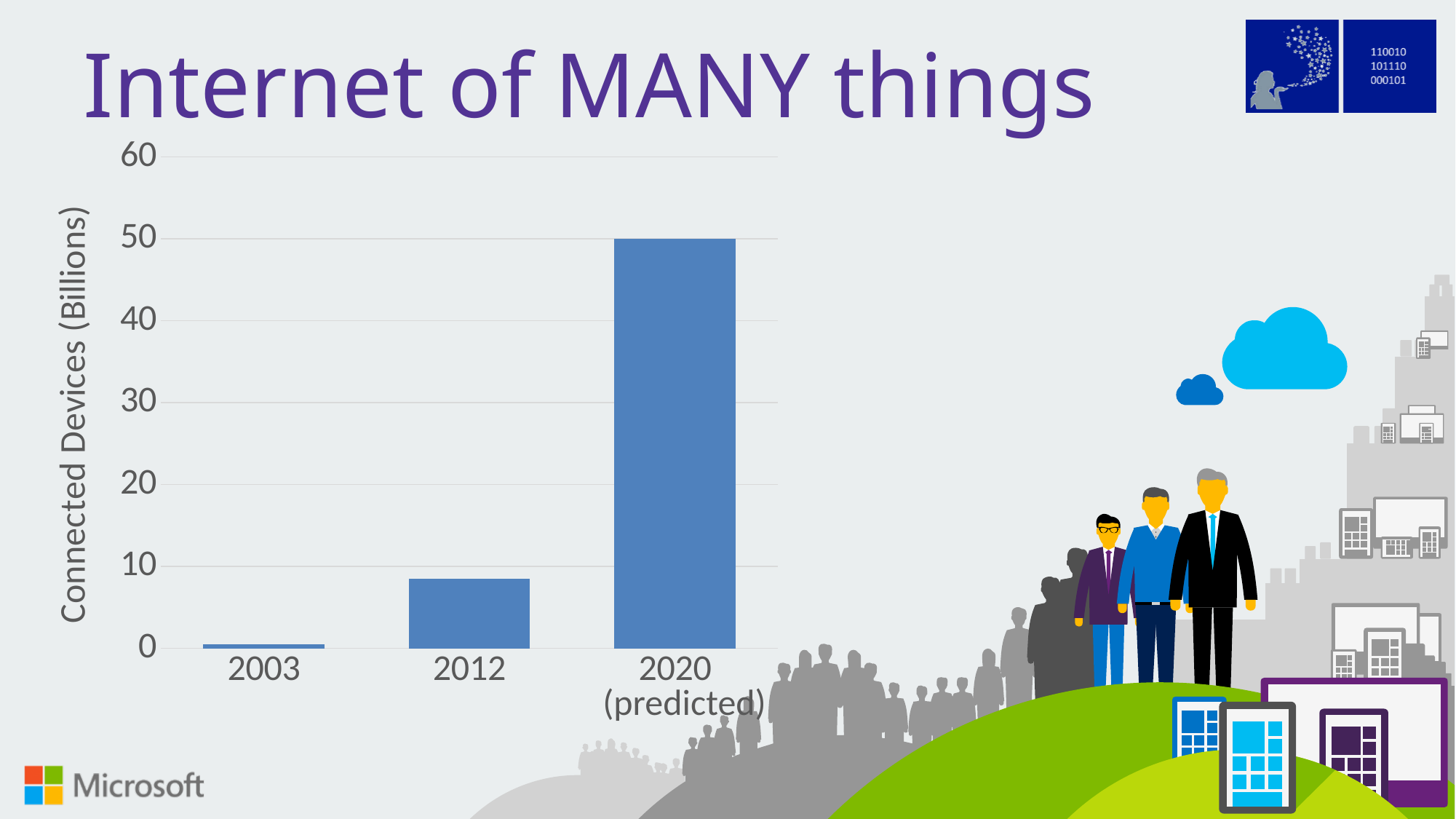
Is the value for 2003 greater or less than 10? less Is the value for 2012 greater or less than 10? less Do the values rise or fall from 2003 to 2020 (predicted)? rise What is the title shown above the chart on the slide? Internet of MANY things Which year has the highest number of connected devices? 2020 (predicted) What is the value for 2020 (predicted) in billions of connected devices? 50 How many categories (years) are plotted on the chart? 3 What kind of chart is shown on the slide? bar chart Which is larger, the value for 2012 or the value for 2003? 2012 Which year has the lowest number of connected devices? 2003 Is the value for 2020 (predicted) greater or less than 40? greater What is the label on the vertical axis of the chart? Connected Devices (Billions)